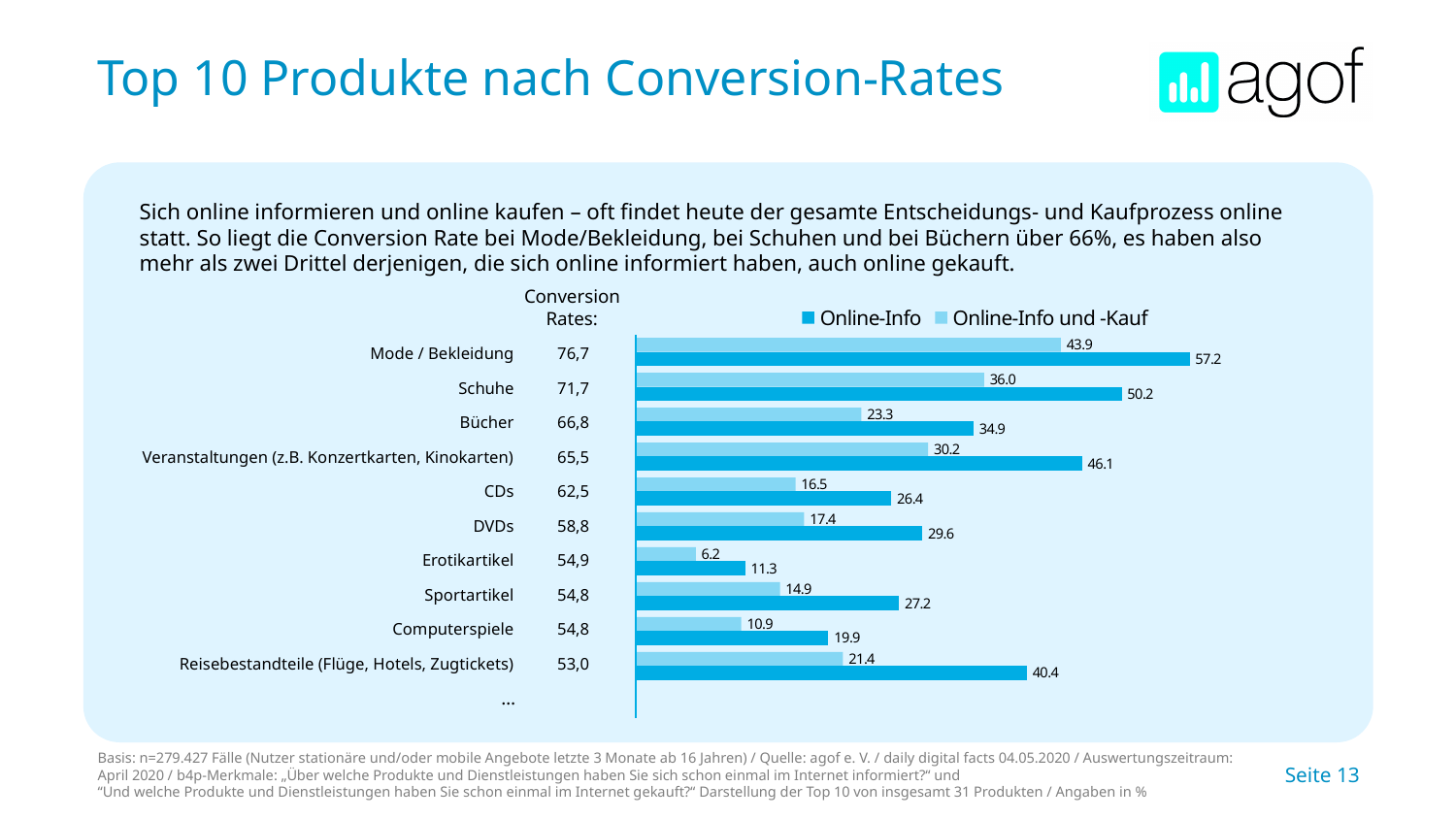
What is the Online-Info und -Kauf value for Computerspiele? 10.9 What is the Online-Info value for Reisebestandteile (Flüge, Hotels, Zugtickets)? 40.4 Which category has the lowest Online-Info und -Kauf value? Erotikartikel What is the Online-Info und -Kauf value for Schuhe? 36.0 How many series does the chart legend list? 2 Which category has the highest Online-Info value? Mode / Bekleidung Which is larger: the Online-Info value for DVDs or the Online-Info value for CDs? DVDs What are the two series named in the chart legend? Online-Info and Online-Info und -Kauf How many product categories are plotted in the chart? 10 What kind of chart is shown on the slide? Bar chart What is the difference between the Online-Info and Online-Info und -Kauf values for Bücher? 11.6 What is the Online-Info value for Mode / Bekleidung? 57.2